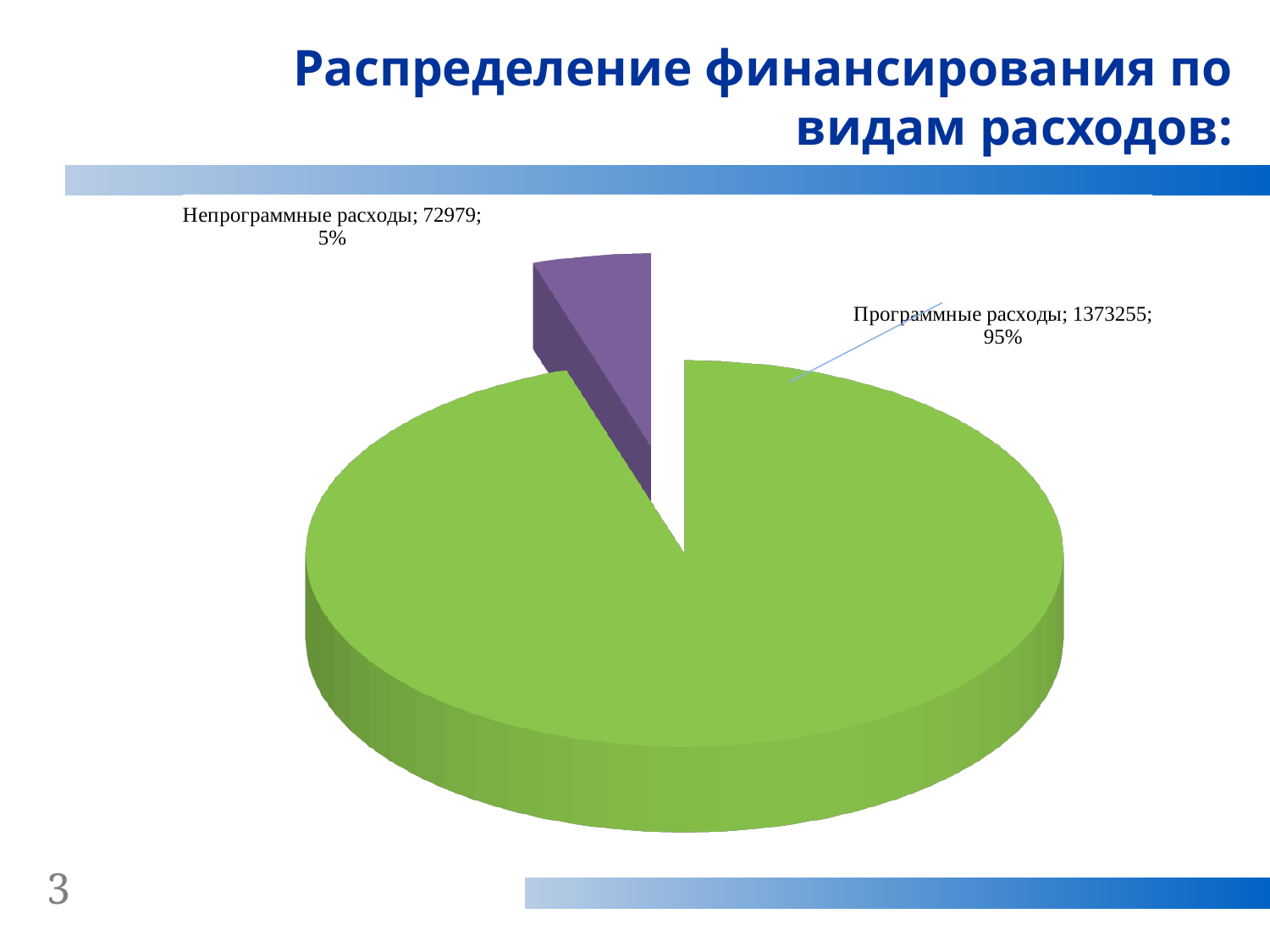
Which category has the smallest slice? Непрограммные расходы What is the value for Программные расходы? 1373255 What is the total of the two values shown in the pie chart? 1446234 What kind of chart is shown on the slide? Pie chart Which category has the largest slice? Программные расходы What is the difference between the values for Программные расходы and Непрограммные расходы? 1300276 What share of the pie does Программные расходы represent? 95% Which is larger, Программные расходы or Непрограммные расходы? Программные расходы How many slices does the pie chart have? 2 What colour is the slice for Непрограммные расходы? Purple What share of the pie does Непрограммные расходы represent? 5% What is the value for Непрограммные расходы? 72979